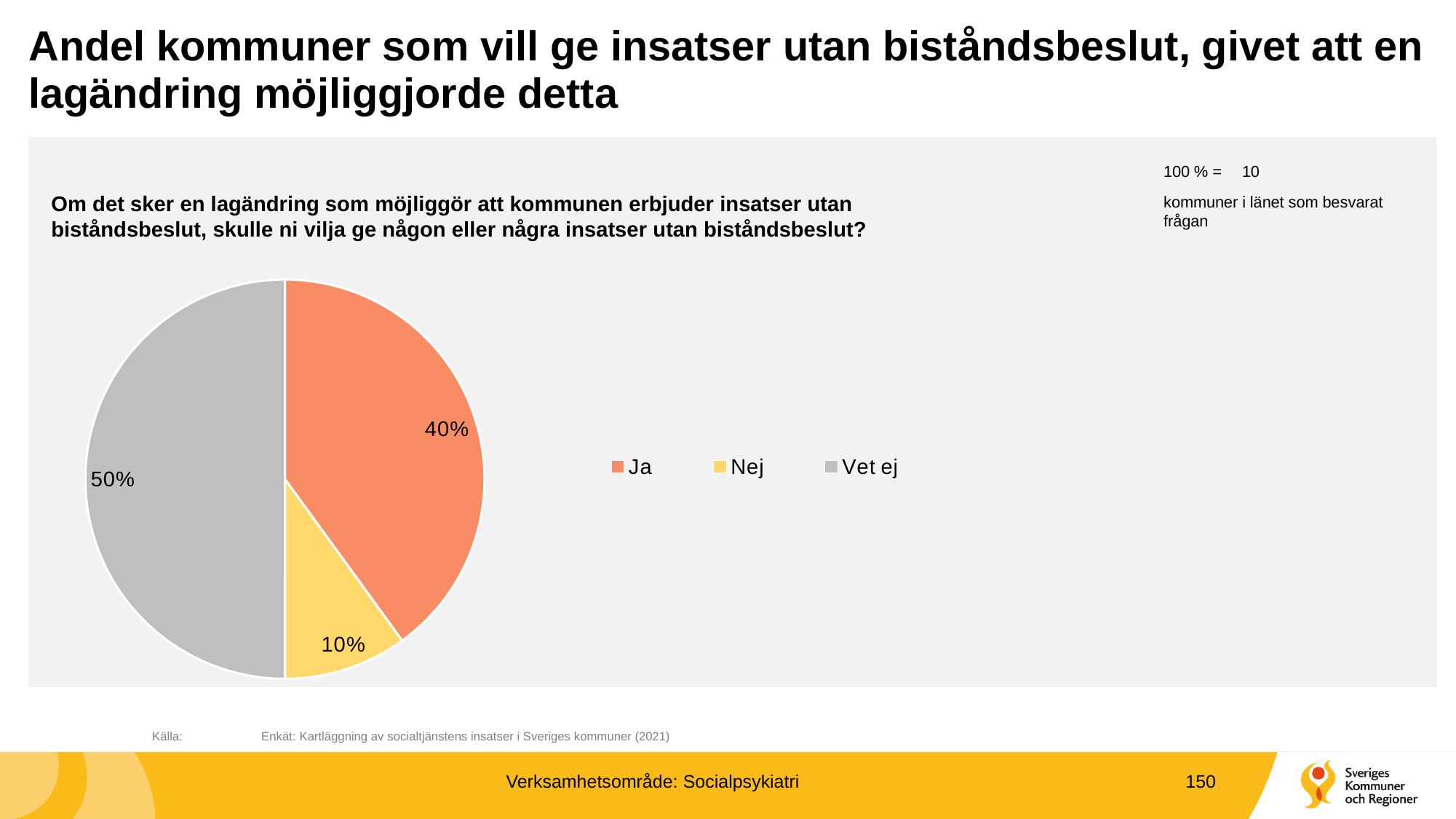
What share of the pie does "Ja" represent? 40% How many categories does the pie chart have? 3 Which category has the smallest slice of the pie? Nej What kind of chart is shown on the slide? pie chart What colour is the "Vet ej" slice in the pie chart? grey Which category has the largest slice of the pie? Vet ej What share of the pie does "Vet ej" represent? 50% What share of the pie does "Nej" represent? 10% What is the difference in percentage points between "Ja" and "Nej"? 30 Which is larger, the share for "Ja" or the share for "Nej"? Ja What is the difference in percentage points between "Vet ej" and "Ja"? 10 How many entries does the legend list? 3